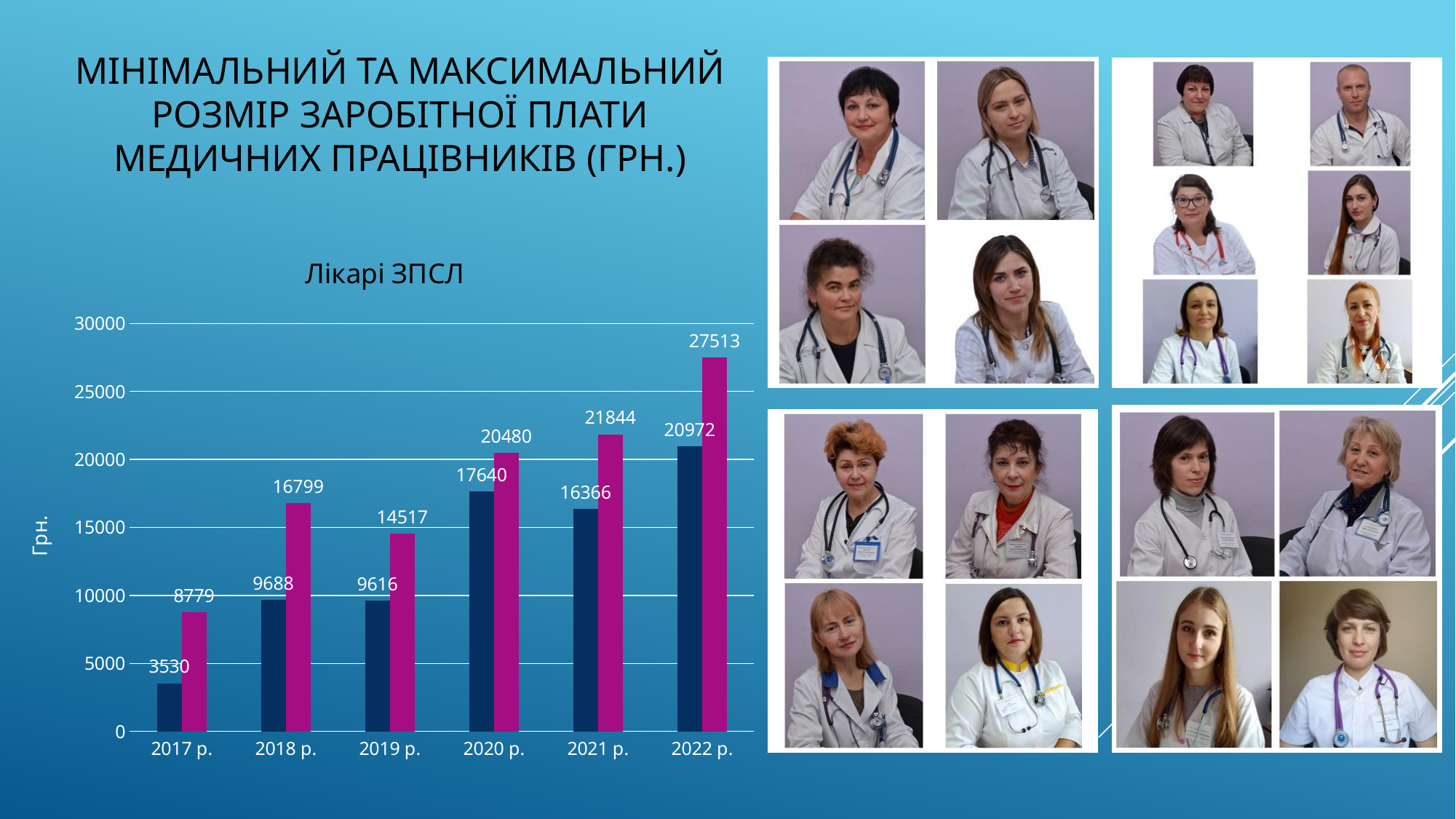
What is the value of the magenta bar for 2019 р.? 14517 What kind of chart is shown on the slide? bar chart Is the value of the dark blue bar for 2021 р. greater or less than 15000? greater How many years are shown on the x axis of the chart? 6 Which is larger: the dark blue bar for 2018 р. or the dark blue bar for 2019 р.? 2018 р. What is the value of the dark blue bar for 2017 р.? 3530 Which year has the lowest dark blue bar? 2017 р. What is the label on the vertical axis of the chart? Грн. Which year has the highest magenta bar? 2022 р. What is the value of the magenta bar for 2022 р.? 27513 What is the title of the chart on the slide? Лікарі ЗПСЛ What is the difference between the magenta and dark blue bars for 2020 р.? 2840